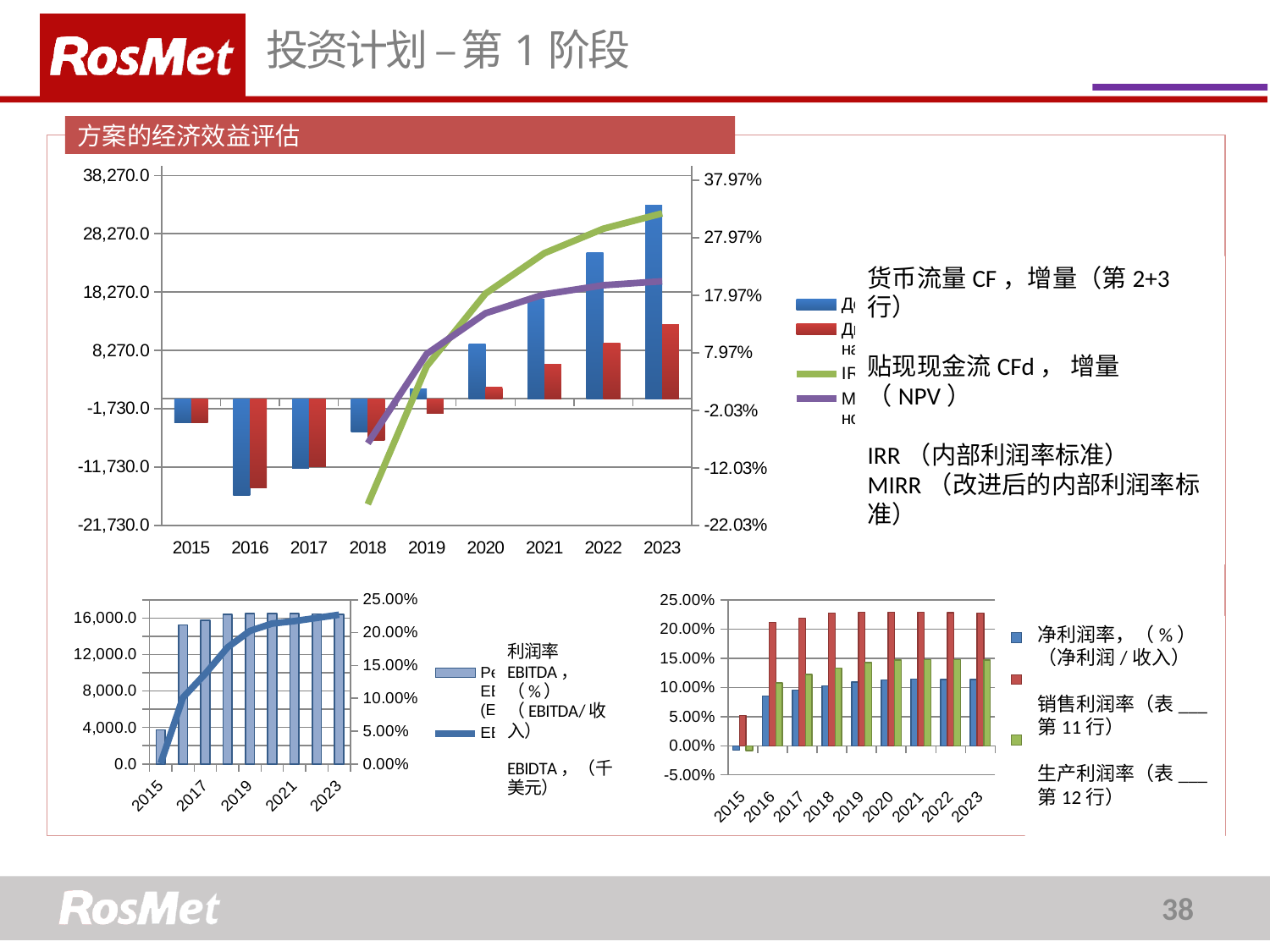
In the top chart, is the blue bar for 2023 greater or less than 28,270.0? greater In the top chart, is the green line value for 2018 greater or less than -12.03%? less In the top chart (方案的经济效益评估), how many years are shown on the x axis? 9 In the top chart, does the green line rise or fall from 2018 to 2023? rise In the bottom-right chart, how many series does the legend list? 3 In the top chart, which year has the lowest blue bar? 2016 In the top chart, which year has the tallest blue bar? 2023 In the bottom-right chart, is the 销售利润率 value for 2016 greater or less than 20.00%? greater In the bottom-left chart, which year has the lowest EBITDA bar? 2015 What kind of chart is the bottom-right chart (净利润率 / 销售利润率 / 生产利润率)? bar chart In the top chart, which is larger in 2022: the blue bar or the red bar? the blue bar